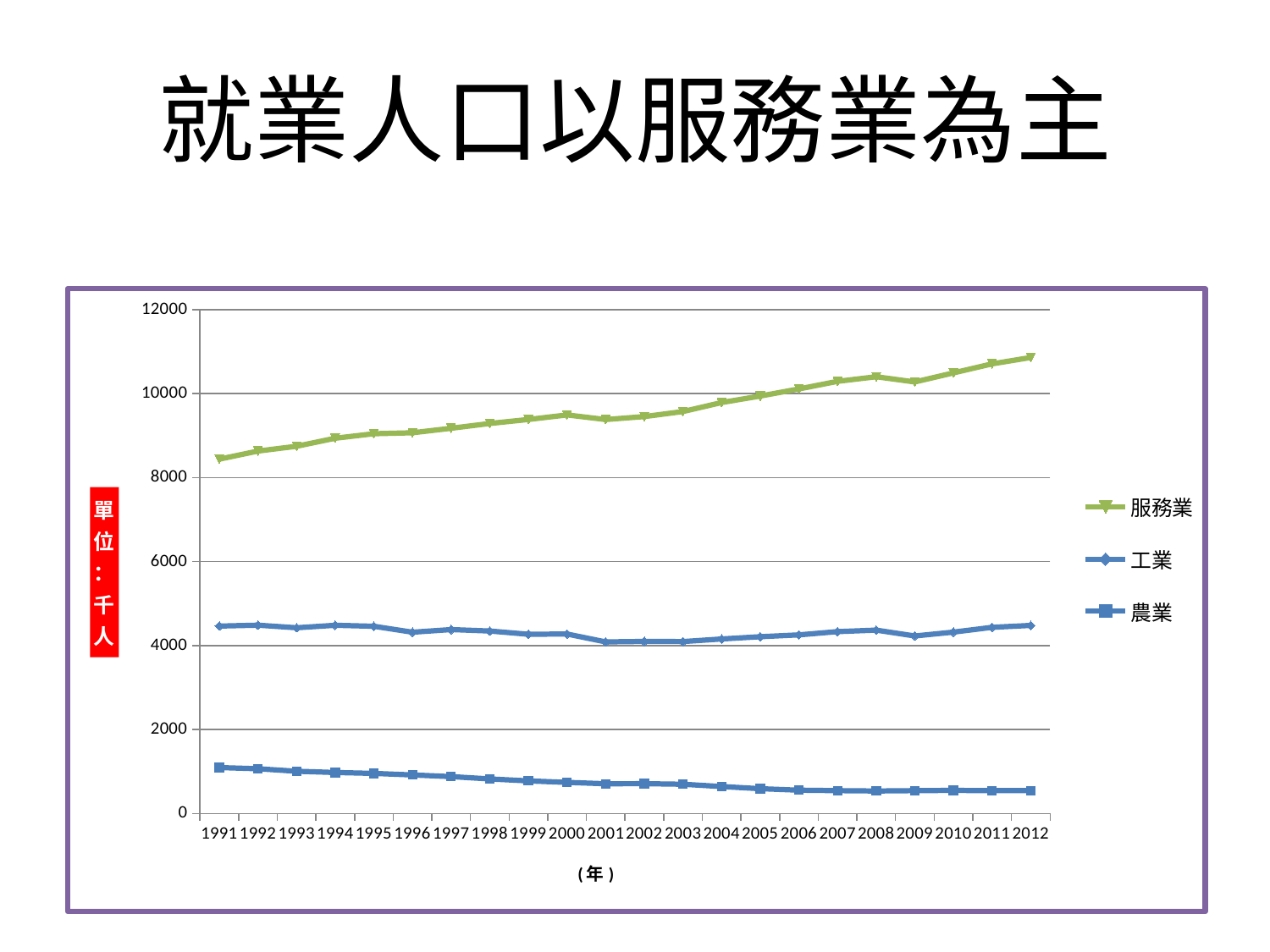
Is the value for 農業 in 1991 greater or less than 2000? less Is the value for 工業 in 2001 greater or less than 6000? less How many years are plotted along the x axis? 22 What unit is given for the values on the chart? 千人 How many series does the legend list? 3 Which series has the lowest values throughout the chart? 農業 Which series has the highest values throughout the chart? 服務業 Which is larger in 2012, the value for 工業 or the value for 農業? 工業 Do the values for 服務業 rise or fall from 1991 to 2012? rise Do the values for 農業 rise or fall from 1991 to 2012? fall What kind of chart is shown on the slide? line chart